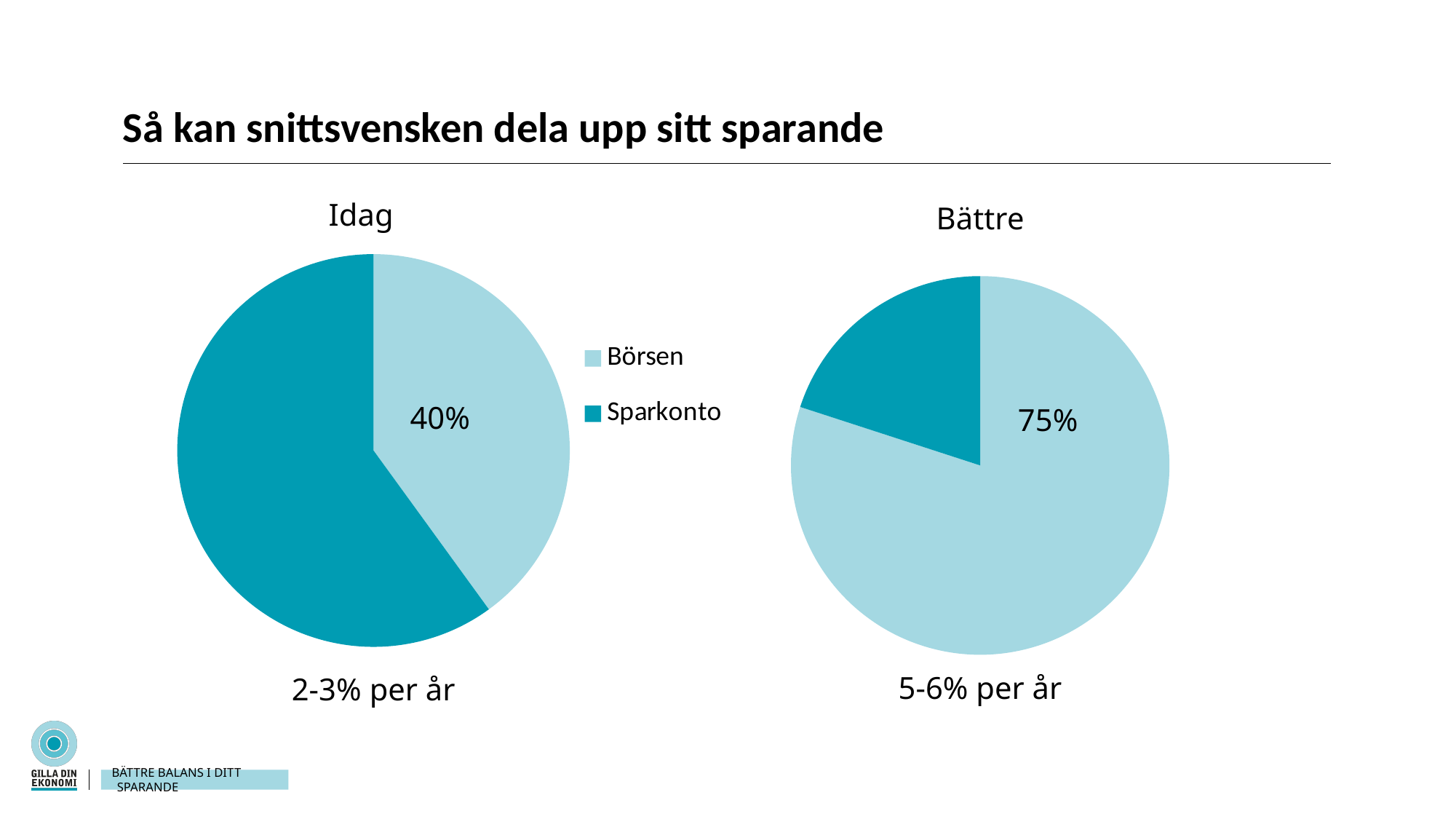
In the "Idag" pie chart, which slice is larger, Börsen or Sparkonto? Sparkonto In the "Bättre" pie chart, which slice is larger, Börsen or Sparkonto? Börsen In the "Idag" pie chart, what share does the Börsen slice have? 40% In the "Bättre" pie chart, what share does the Börsen slice have? 75% What kind of chart is the "Idag" chart? Pie chart What annual return text is shown below the "Bättre" pie chart? 5-6% per år How many slices does the "Bättre" pie chart have? 2 How many entries does the legend between the two pie charts list? 2 What is the title of the slide containing the two pie charts? Så kan snittsvensken dela upp sitt sparande In the "Bättre" pie chart, which category has the smallest slice? Sparkonto Is the Börsen share in the "Bättre" pie chart greater or less than the Börsen share in the "Idag" pie chart? greater In the "Idag" pie chart, which category has the largest slice? Sparkonto